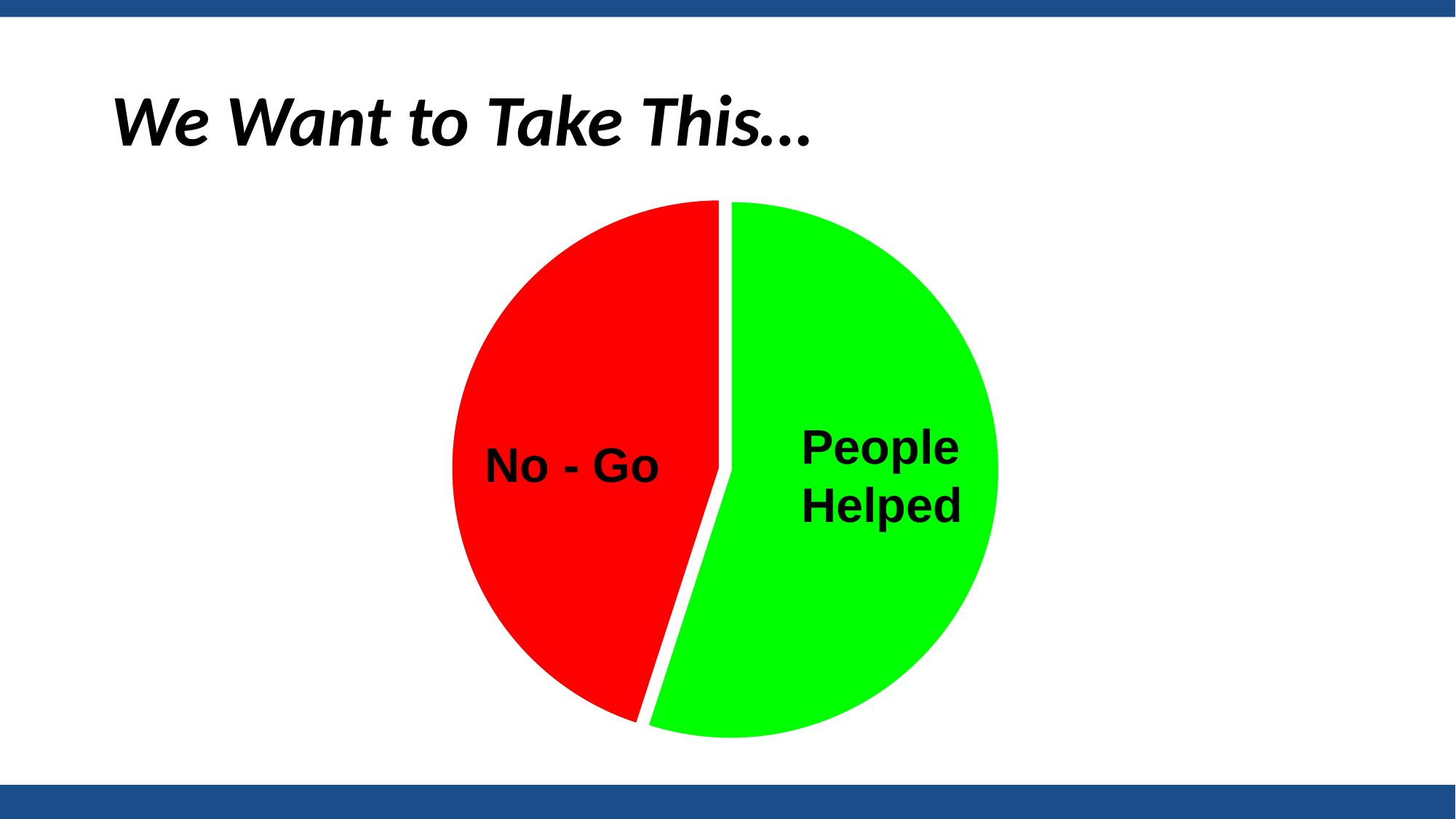
What colour is the No - Go slice? red Which slice of the pie chart is the largest? People Helped Which slice of the pie chart is the smallest? No - Go What kind of chart is shown on the slide? pie chart Is the People Helped slice more or less than half of the pie? more What colour is the People Helped slice? green Which slice is larger, No - Go or People Helped? People Helped Is the No - Go slice more or less than half of the pie? less How many slices does the pie chart have? 2